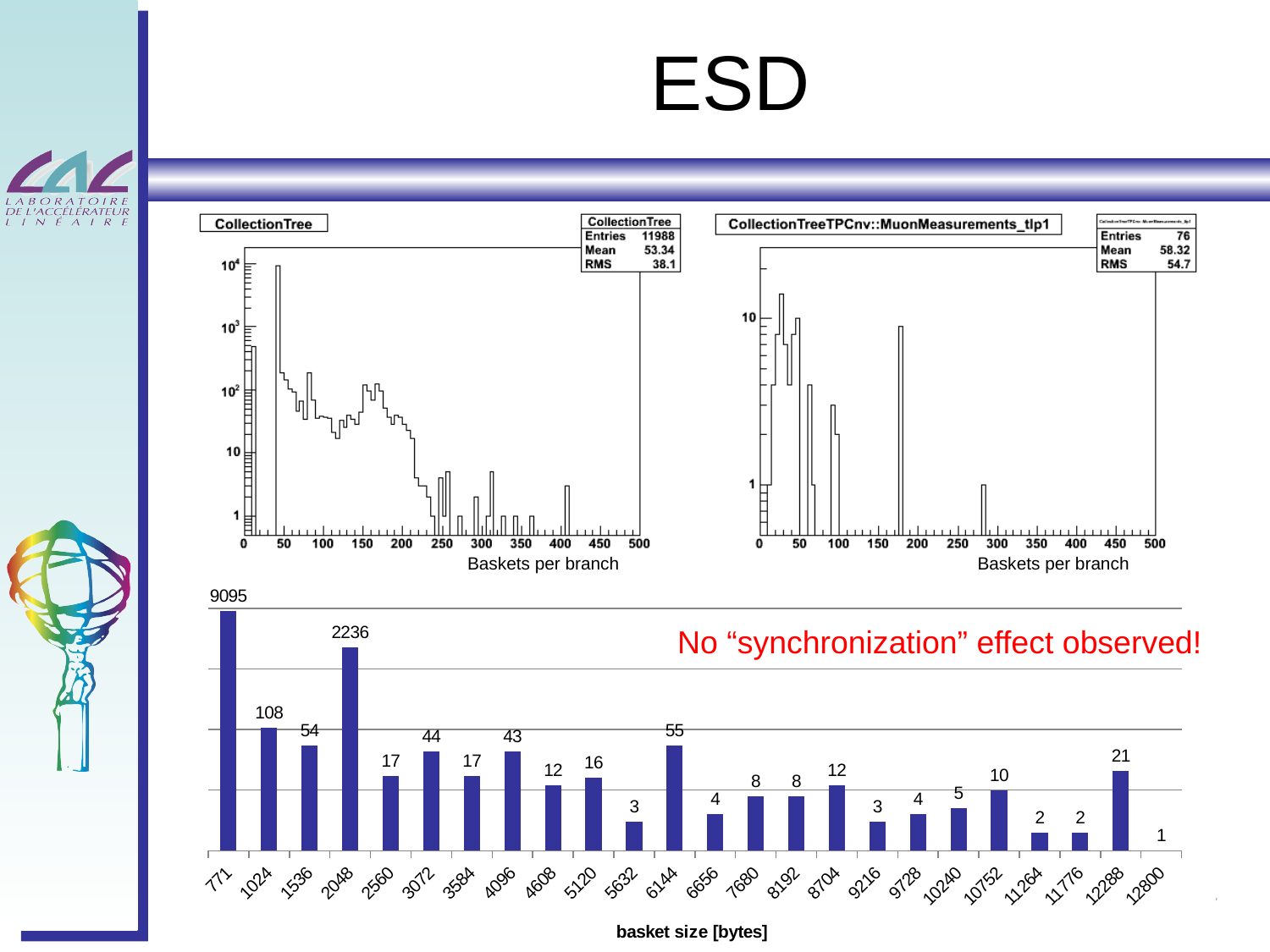
What is the x-axis label of the two top histograms? Baskets per branch In the bottom bar chart of basket size [bytes], what is the value for basket size 6144? 55 In the bottom bar chart of basket size [bytes], what is the value for basket size 2048? 2236 In the top-left histogram titled CollectionTree, how many entries does the statistics box report? 11988 In the bottom bar chart of basket size [bytes], what is the difference between the values for basket sizes 771 and 2048? 6859 What kind of chart is the bottom chart of basket size [bytes]? bar chart In the bottom bar chart of basket size [bytes], which has the larger value, basket size 1024 or basket size 12288? 1024 In the bottom bar chart of basket size [bytes], what is the value for basket size 771? 9095 How many basket size categories are shown on the x axis of the bottom bar chart? 24 In the top-right histogram titled CollectionTreeTPCnv::MuonMeasurements_tlp1, what mean does the statistics box report? 58.32 In the bottom bar chart of basket size [bytes], which basket size has the highest value? 771 In the bottom bar chart of basket size [bytes], which basket size has the lowest value? 12800